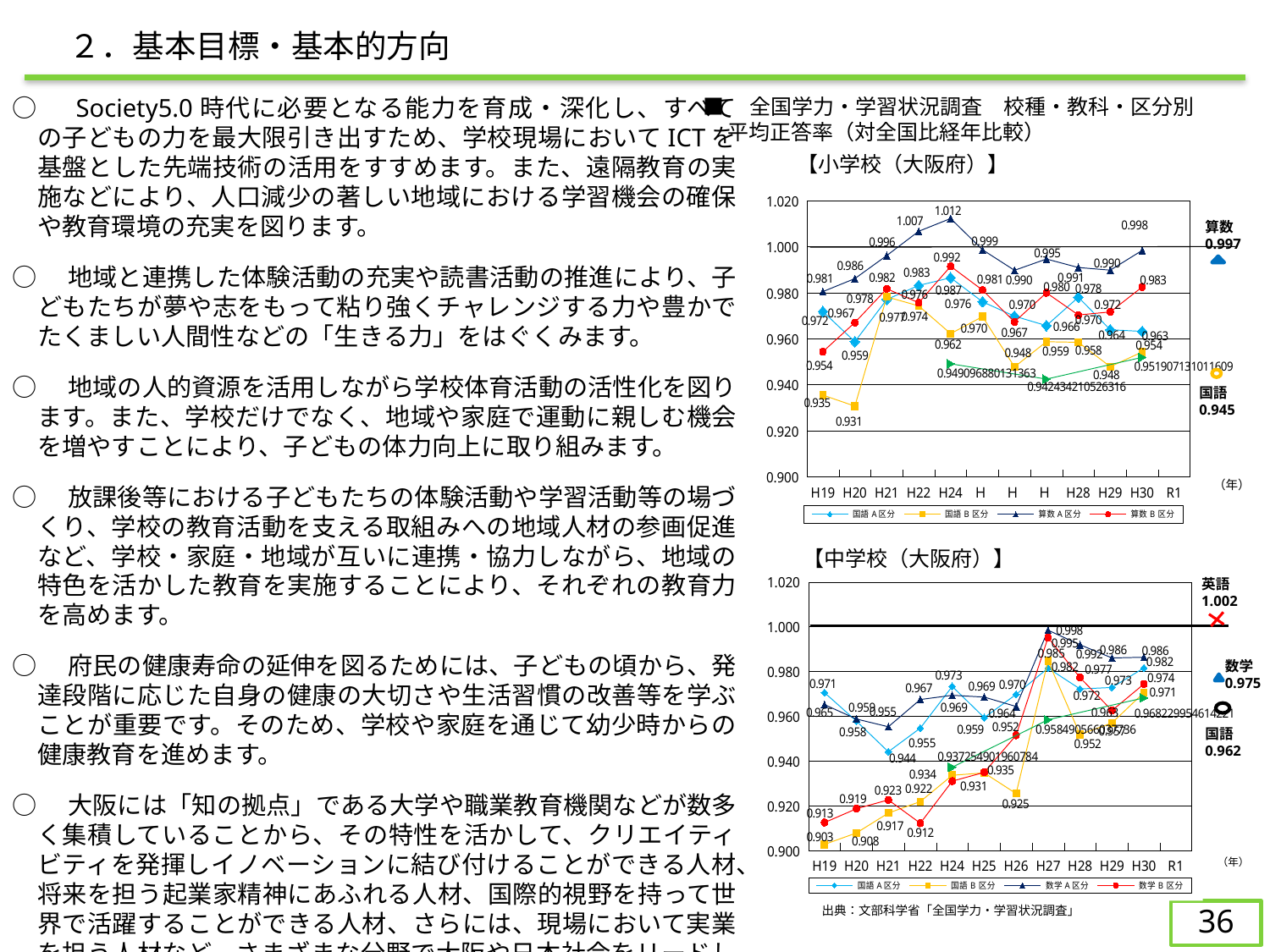
In the 【小学校（大阪府）】 chart, which series and year has the highest plotted value? 算数A区分 at H24 In the 【中学校（大阪府）】 chart, what is the lowest plotted value? 0.903 How many year categories are on the x axis of the 【中学校（大阪府）】 chart? 12 In the 【小学校（大阪府）】 chart, what is the value of 算数A区分 at H24? 1.012 What type of chart is the 【小学校（大阪府）】 chart? line chart How many series does the legend of the 【小学校（大阪府）】 chart list? 4 In the 【中学校（大阪府）】 chart, what is the value of 国語B区分 at H19? 0.903 In the 【中学校（大阪府）】 chart, is the value of 国語B区分 at H26 greater or less than 0.940? less In the 【小学校（大阪府）】 chart at H24, which is larger: 算数A区分 or 国語B区分? 算数A区分 In the 【小学校（大阪府）】 chart, what is the value of 国語B区分 at H20? 0.931 In the 【小学校（大阪府）】 chart, what is the difference between 算数A区分 at H24 and at H22? 0.005 What value is annotated for 英語 on the right side of the 【中学校（大阪府）】 chart? 1.002